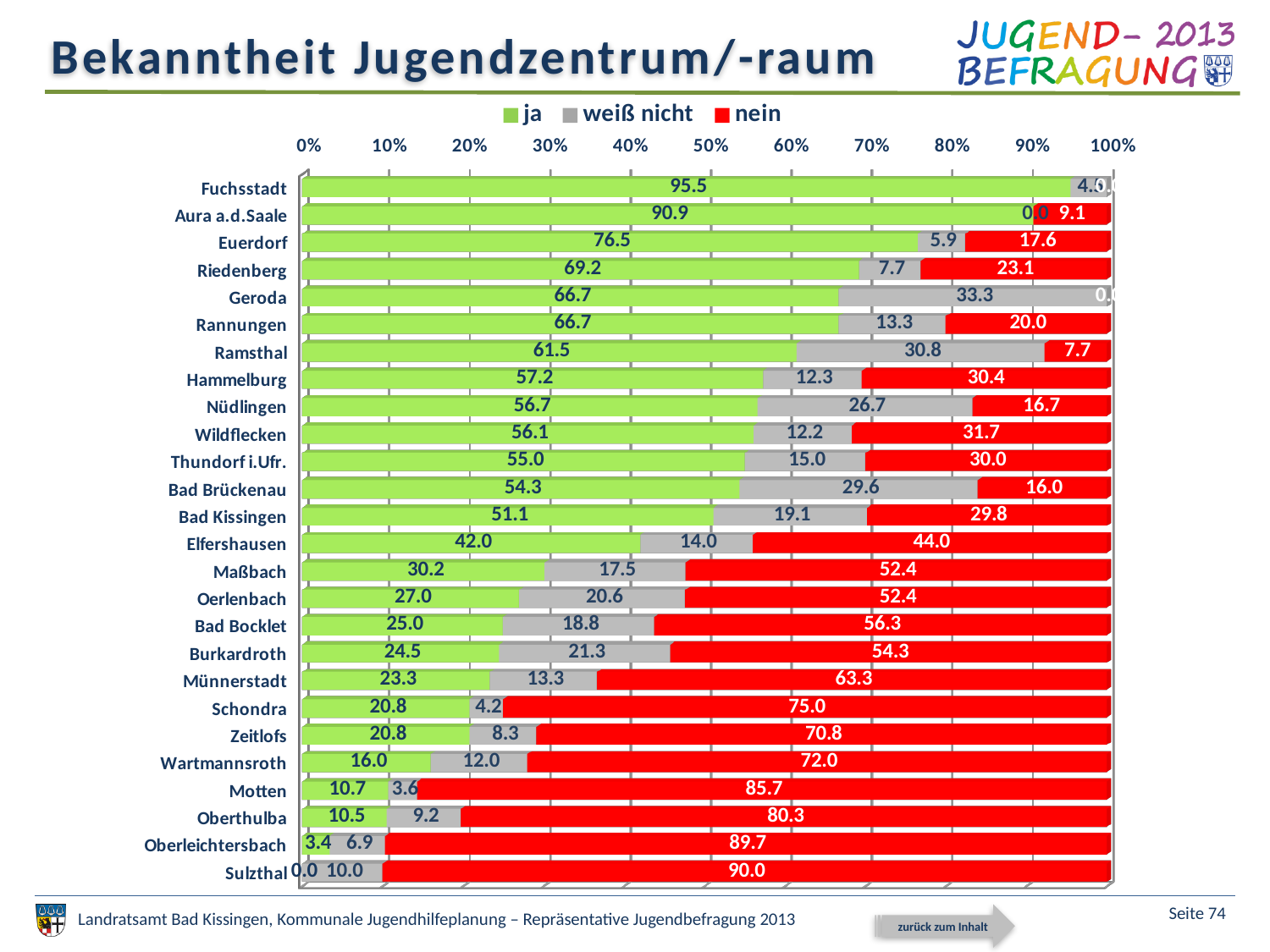
What is the value for "ja" for Fuchsstadt? 95.5 Which municipality has the lowest value for "ja"? Sulzthal Which municipality has the highest value for "ja"? Fuchsstadt How many municipalities are shown in the chart? 26 Which has the larger "ja" value, Maßbach or Oerlenbach? Maßbach How many series does the legend list? 3 What is the value for "nein" for Hammelburg? 30.4 Is the "nein" value for Münnerstadt greater or less than 60%? greater What kind of chart is shown on the slide? bar chart What is the difference between the "nein" and "weiß nicht" values for Euerdorf? 11.7 What is the value for "weiß nicht" for Ramsthal? 30.8 What is the value for "nein" for Sulzthal? 90.0